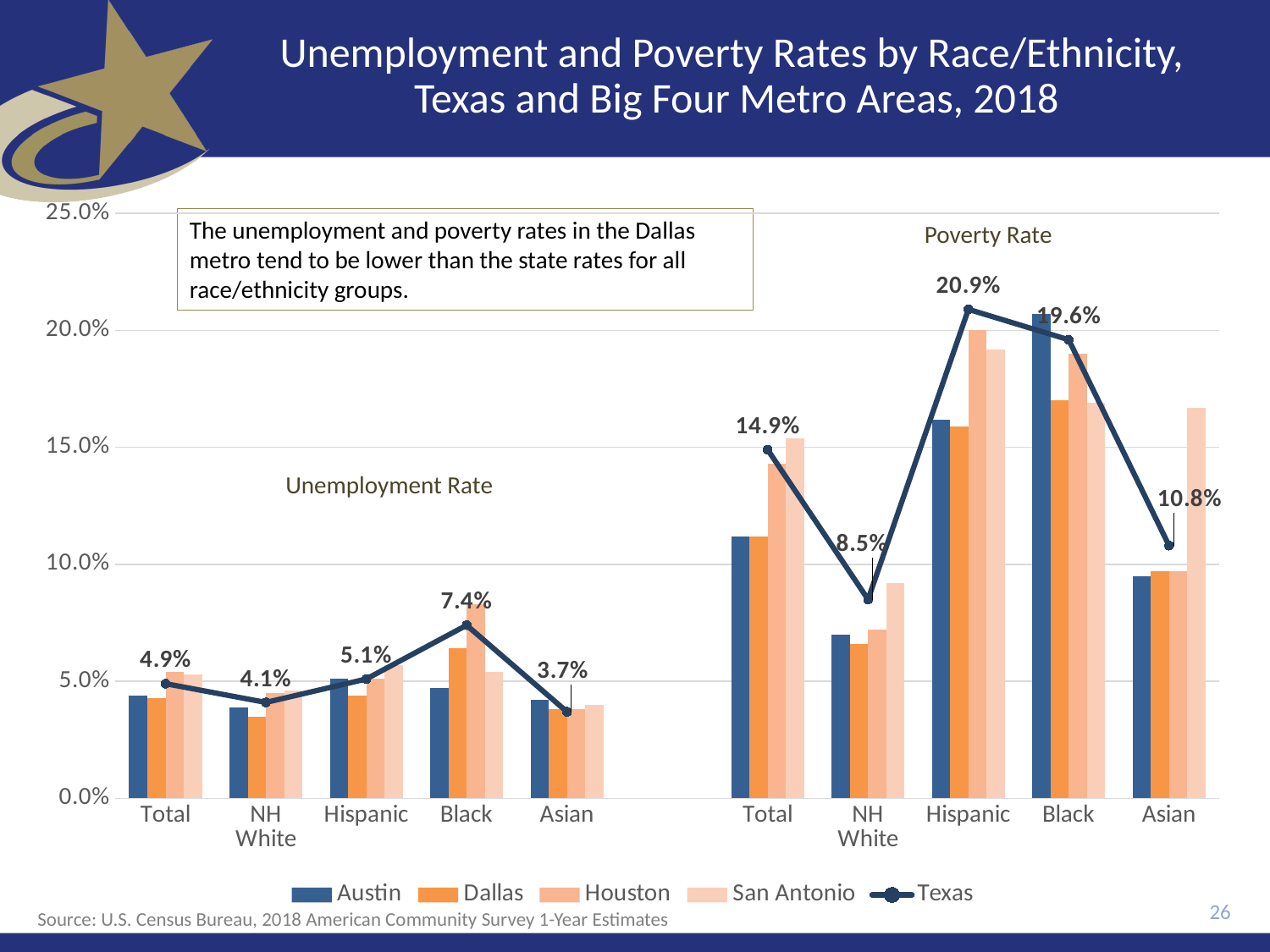
Which is larger, the Texas unemployment rate for Total or for NH White? Total Among the Texas poverty rate labels, which race/ethnicity group has the highest value? Hispanic Is the Dallas poverty rate for NH White residents greater or less than 10.0%? less How many series does the legend list? 5 Which series is drawn as a line rather than bars? Texas Is the San Antonio poverty rate for Asian residents greater or less than 15.0%? greater What is the Texas unemployment rate for Black residents? 7.4% What is the difference between the Texas poverty rate for Hispanic residents (20.9%) and for NH White residents (8.5%)? 12.4% What is the Texas poverty rate for the Total category? 14.9% Among the Texas unemployment rate labels, which race/ethnicity group has the lowest value? Asian How many race/ethnicity categories are shown in the Poverty Rate section of the chart? 5 What is the Texas poverty rate for Hispanic residents? 20.9%